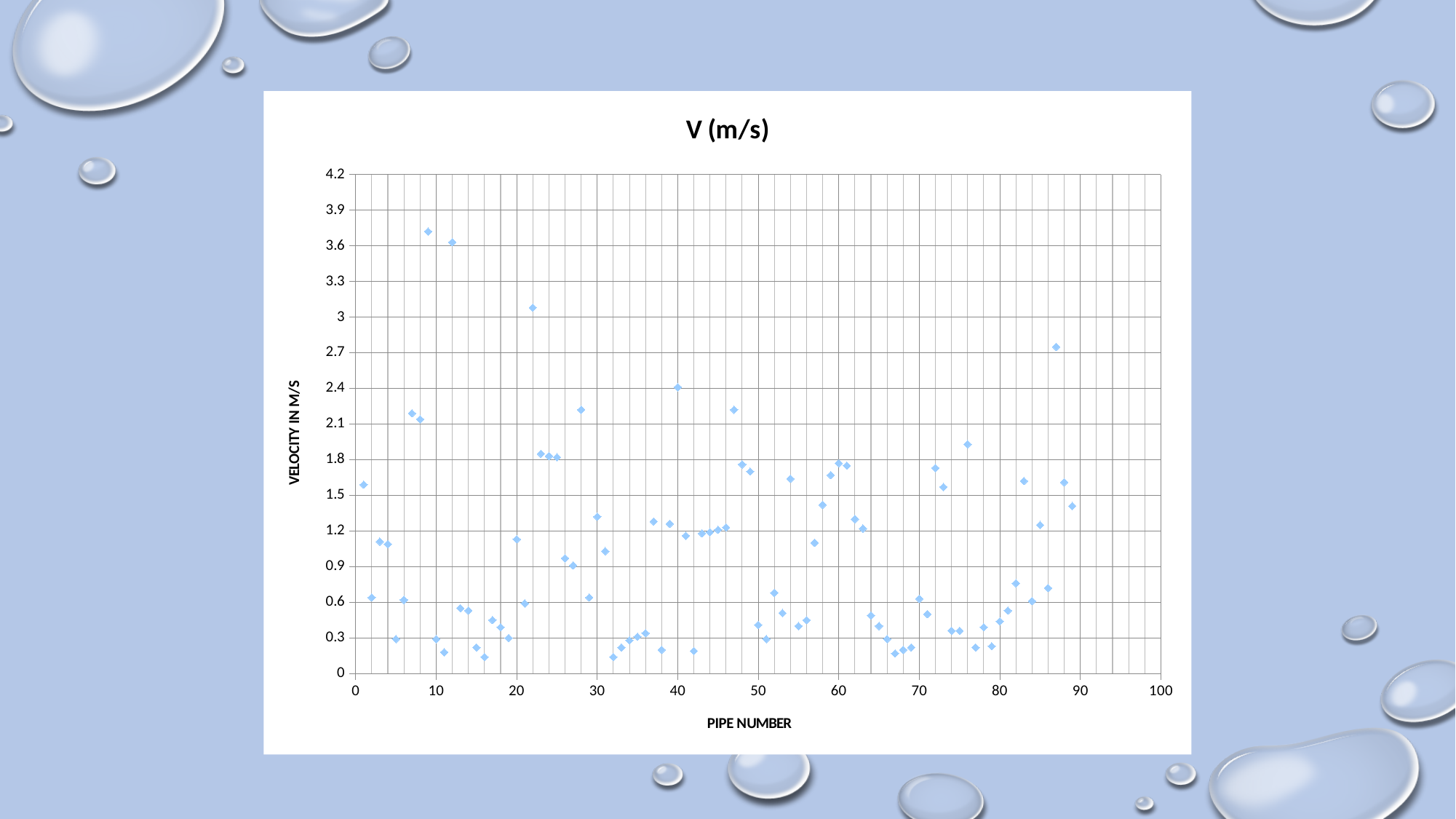
Is the velocity for pipe number 9 greater or less than 3.3? greater Which has the higher velocity, pipe number 9 or pipe number 22? pipe number 9 Is the velocity for pipe number 22 greater or less than 2.7? greater What kind of chart is shown on the slide? scatter chart Is the velocity for pipe number 47 greater or less than 1.8? greater Which pipe number has the highest velocity? 9 What is the label on the horizontal axis of the chart? PIPE NUMBER Which has the higher velocity, pipe number 87 or pipe number 47? pipe number 87 What is the title of the chart? V (m/s)